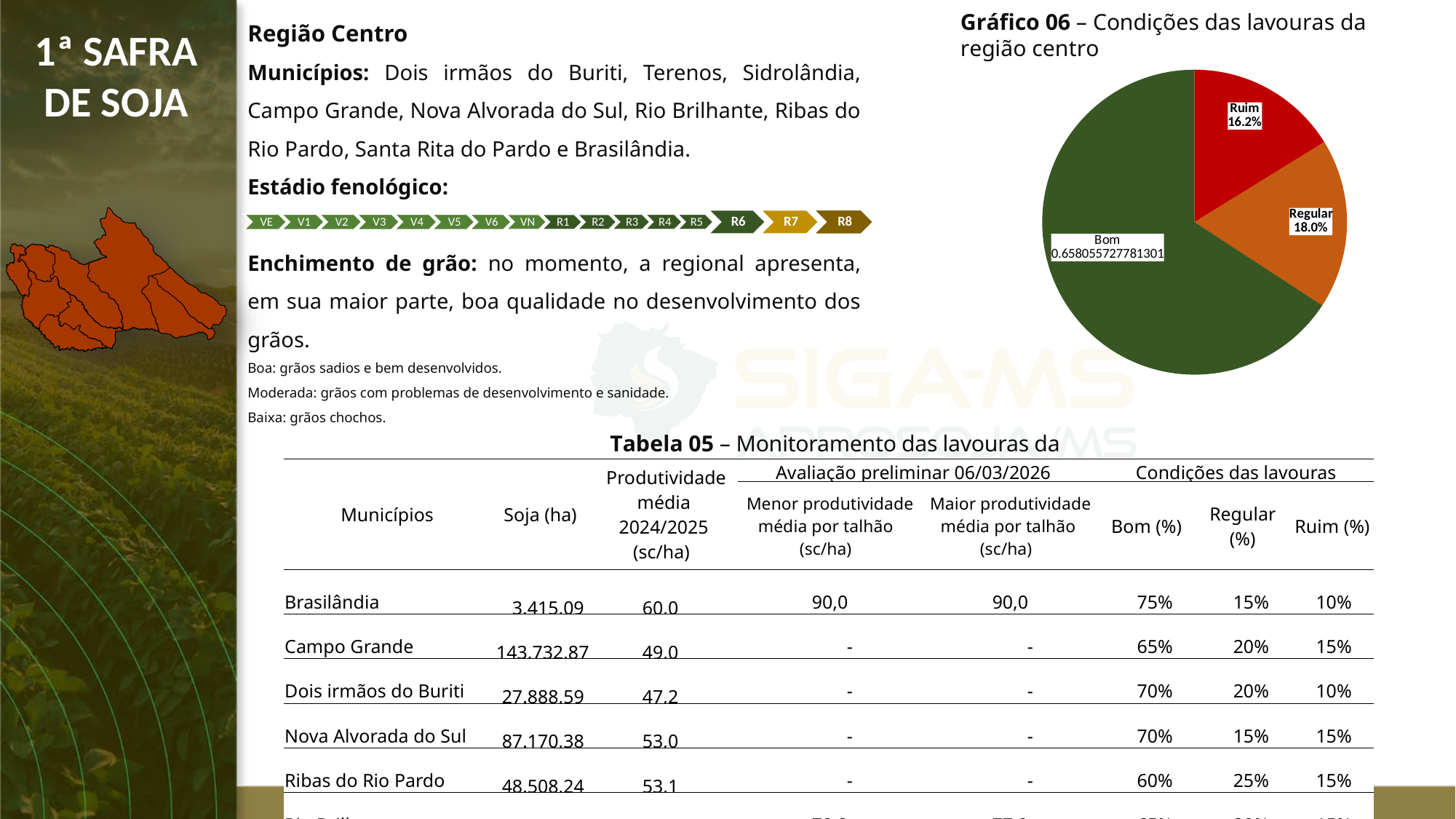
In Gráfico 06, which category has the smallest slice? Ruim In Gráfico 06, what share of the pie is labelled Regular? 18.0% In Gráfico 06, what value is printed on the Bom slice? 0.658055727781301 In Gráfico 06, what share of the pie is labelled Ruim? 16.2% How many slices does the pie in Gráfico 06 have? 3 In Gráfico 06, which slice is larger, Regular or Ruim? Regular In Gráfico 06, by how many percentage points does Regular exceed Ruim? 1.8 What kind of chart is Gráfico 06? pie chart What is the title of the pie chart on the slide? Gráfico 06 – Condições das lavouras da região centro In Gráfico 06, what colour is the Ruim slice? red In Gráfico 06, which category has the largest slice? Bom